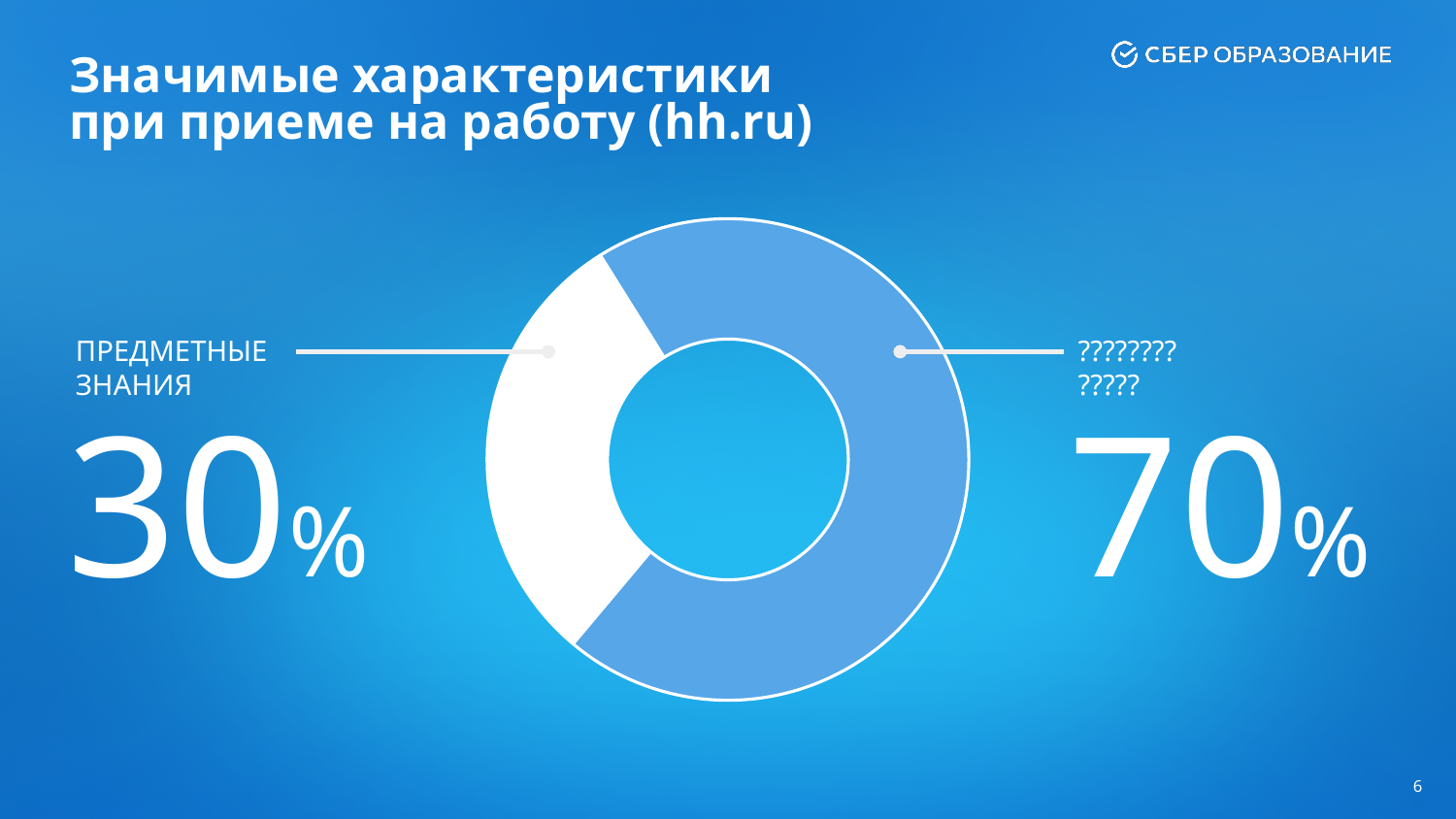
What is the difference between the blue slice (70%) and «Предметные знания» (30%)? 40 percentage points What is the title of the slide containing the donut chart? Значимые характеристики при приеме на работу (hh.ru) What share of the donut chart does «Предметные знания» take? 30% What is the value of the largest slice in the donut chart? 70% What percentage is shown for the blue slice of the donut chart? 70% What do the two slices of the donut chart add up to? 100% What percentage is shown for «Предметные знания» in the donut chart? 30% Which is larger: the slice for «Предметные знания» or the blue slice? The blue slice What colour is the slice for «Предметные знания» in the donut chart? White Which slice of the donut chart is the smallest? Предметные знания What kind of chart is shown on the slide? Pie chart (donut) How many slices does the donut chart have? 2